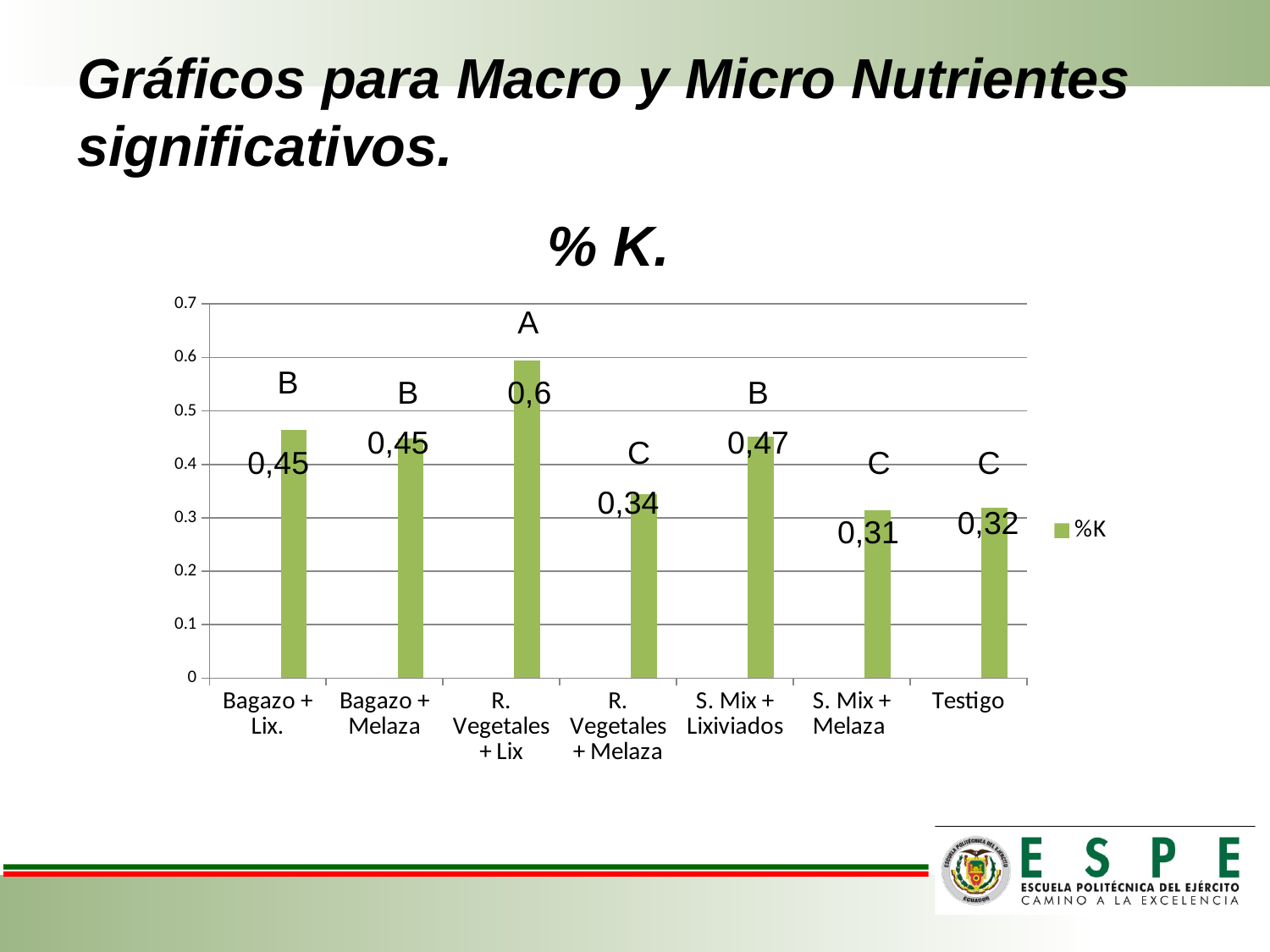
Which category has the lowest value? S. Mix + Melaza Is the value for Bagazo + Lix. greater or less than 0.4? greater What is the value for Testigo? 0,32 Which category has the highest value? R. Vegetales + Lix What kind of chart is this? Bar chart What is the value for R. Vegetales + Lix? 0,6 What is the value for R. Vegetales + Melaza? 0,34 What is the title of the chart? % K. How many categories are shown on the x axis? 7 Which is larger, the value for S. Mix + Lixiviados or the value for Bagazo + Melaza? S. Mix + Lixiviados What is the value for S. Mix + Lixiviados? 0,47 What is the difference between the values for R. Vegetales + Lix and S. Mix + Melaza? 0,29